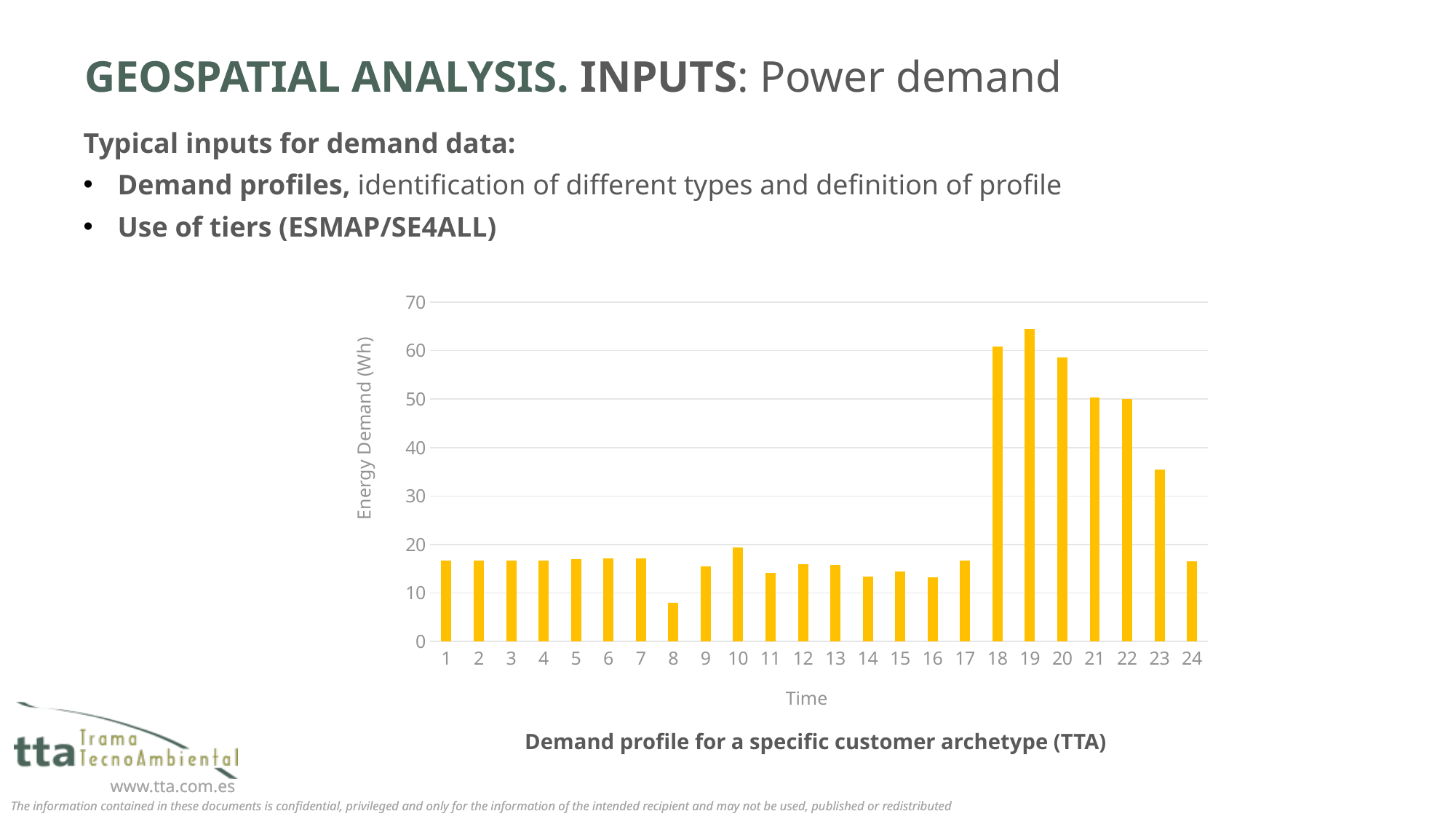
Is the energy demand at hour 8 greater or less than 10? less Which hour has the higher energy demand, hour 19 or hour 20? 19 At which hour is the energy demand highest? 19 How many time categories are plotted on the x axis of the chart? 24 Is the energy demand at hour 23 greater or less than 30? greater Which hour has the higher energy demand, hour 22 or hour 23? 22 Is the energy demand at hour 1 greater or less than 20? less At which hour is the energy demand lowest? 8 What kind of chart is shown on the slide? bar chart Do the energy demand values rise or fall from hour 19 to hour 24? fall What is the label of the vertical axis of the chart? Energy Demand (Wh)